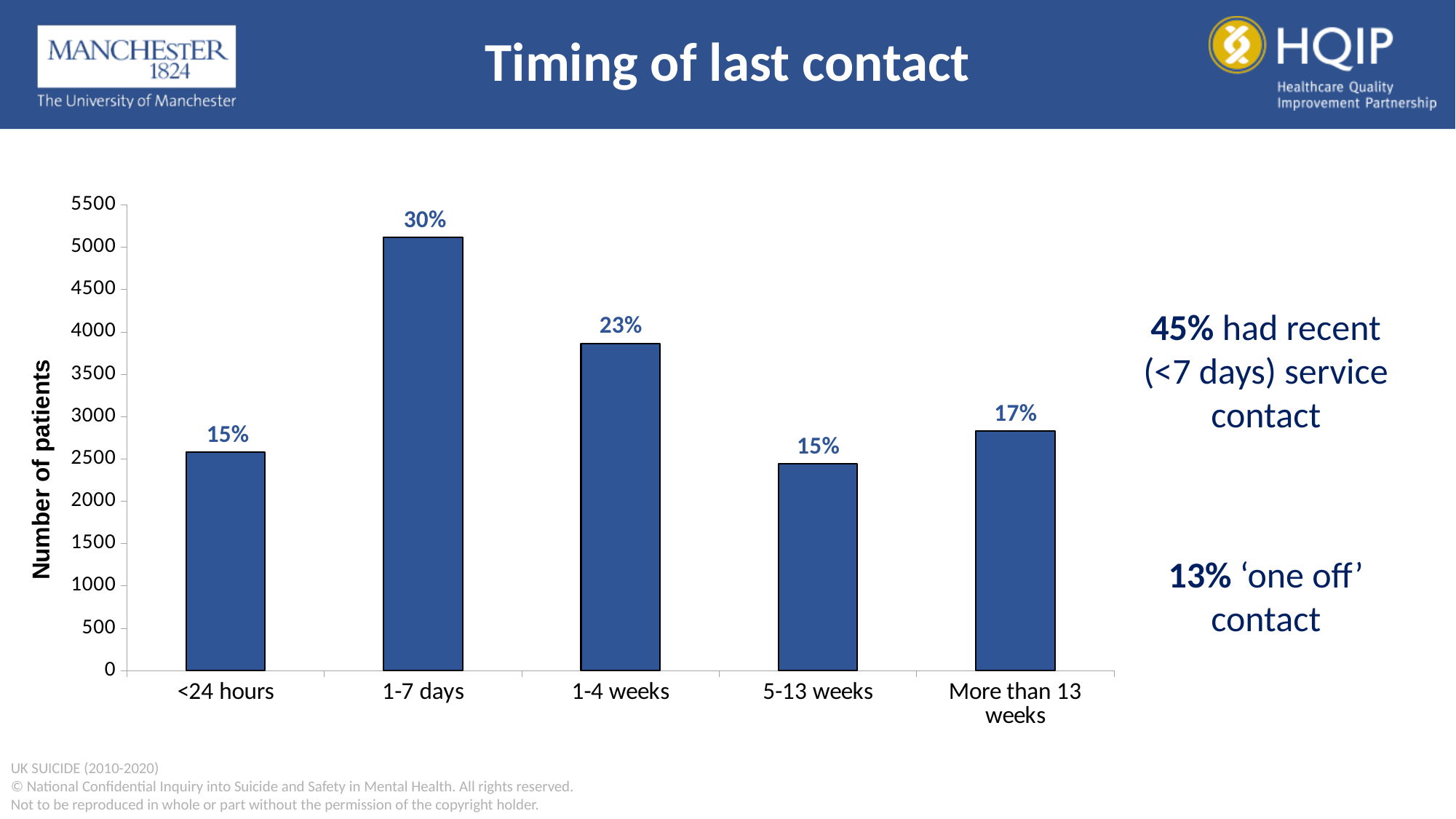
Which category has the highest number of patients? 1-7 days How many categories are shown on the x axis? 5 What percentage label is shown on the bar for More than 13 weeks? 17% Which has more patients, 1-4 weeks or More than 13 weeks? 1-4 weeks Is the number of patients for 1-7 days greater or less than 5000? greater What is the difference in percentage points between the 1-7 days bar and the 5-13 weeks bar? 15 percentage points What percentage label is shown on the bar for 1-4 weeks? 23% Is the number of patients for More than 13 weeks greater or less than 3000? less Is the number of patients for 1-4 weeks greater or less than 4000? less What kind of chart is shown on the slide? Bar chart What percentage label is shown on the bar for <24 hours? 15% What percentage label is shown on the bar for 1-7 days? 30%